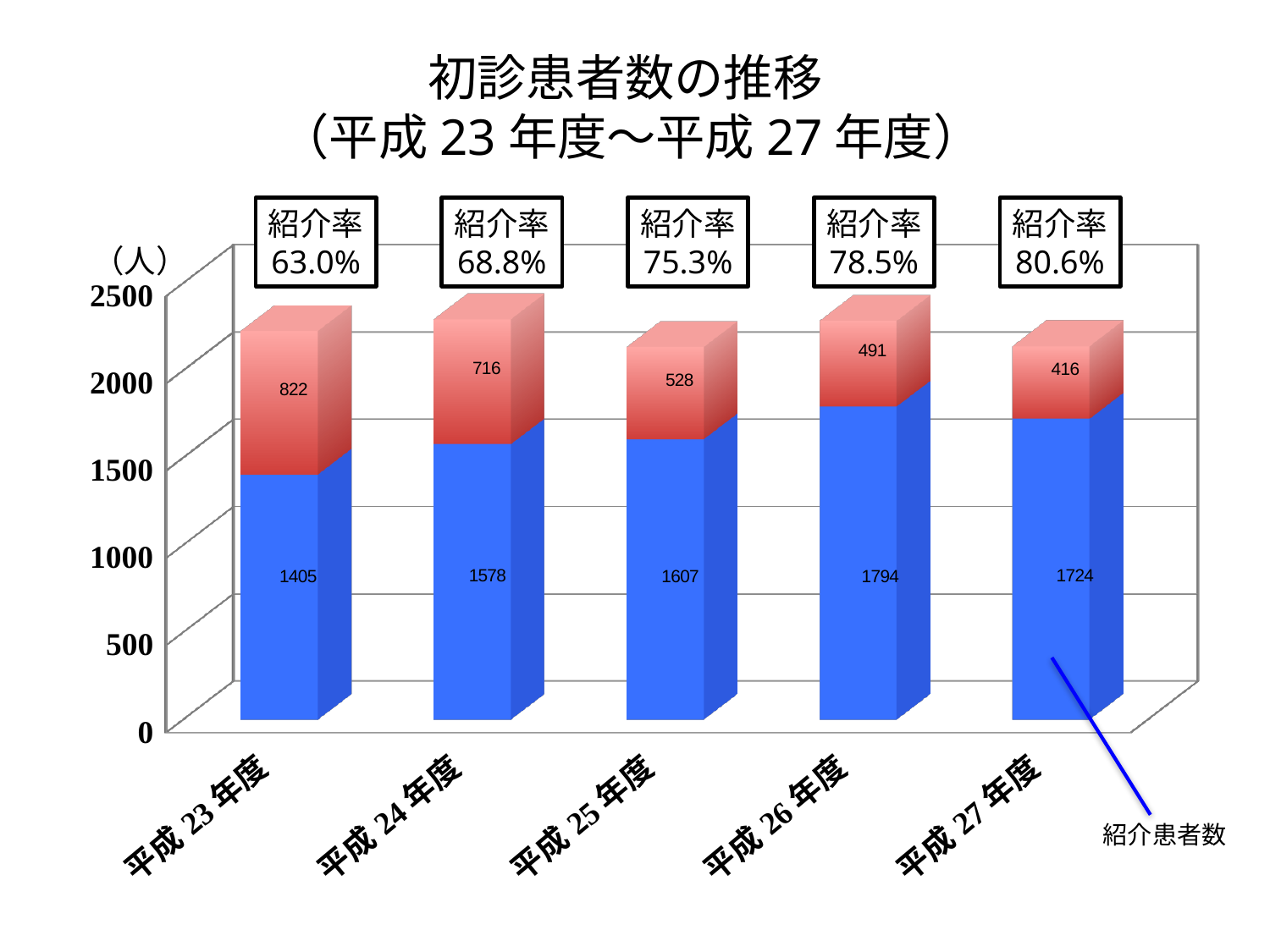
Which year has the highest value for the blue segment (紹介患者数)? 平成26年度 Does the 紹介率 rise or fall from 平成23年度 to 平成27年度? Rise What is the unit shown at the top of the vertical axis? （人） What kind of chart is shown on the slide? Stacked bar chart What is the value of the red (upper) segment for 平成25年度? 528 What is the value of the blue segment (紹介患者数) for 平成23年度? 1405 Which year has the lowest value for the red (upper) segment? 平成27年度 How many years (categories) are shown on the x axis? 5 What is the difference between the blue segment values for 平成26年度 and 平成27年度? 70 What is the 紹介率 shown above the bar for 平成26年度? 78.5% What is the total of the stacked bar for 平成24年度? 2294 Which is larger, the red segment for 平成23年度 or the red segment for 平成24年度? 平成23年度